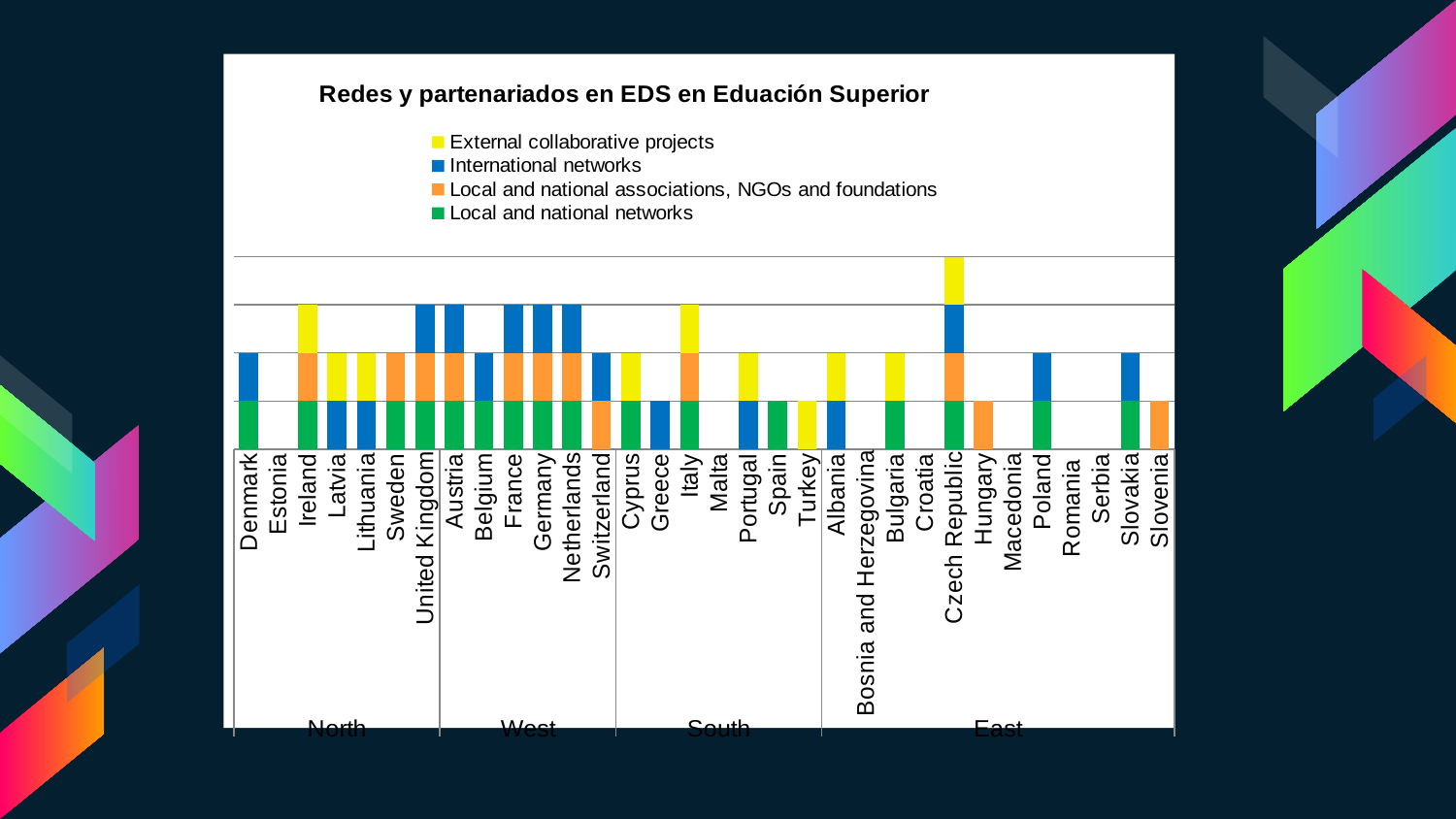
Which is larger, the total bar for Czech Republic or the total bar for Ireland? Czech Republic What kind of chart is shown on the slide? Stacked bar chart Which country has the tallest stacked bar? Czech Republic How many series does the legend list? 4 Which is larger, the total bar for Italy or the total bar for Greece? Italy What is the title of the chart? Redes y partenariados en EDS en Eduación Superior How many countries are shown along the x axis? 32 Which series is shown in yellow in the legend? External collaborative projects Which is larger, the total bar for Denmark or the total bar for Turkey? Denmark How many countries are in the East group? 12 How many countries have no bar at all? 7